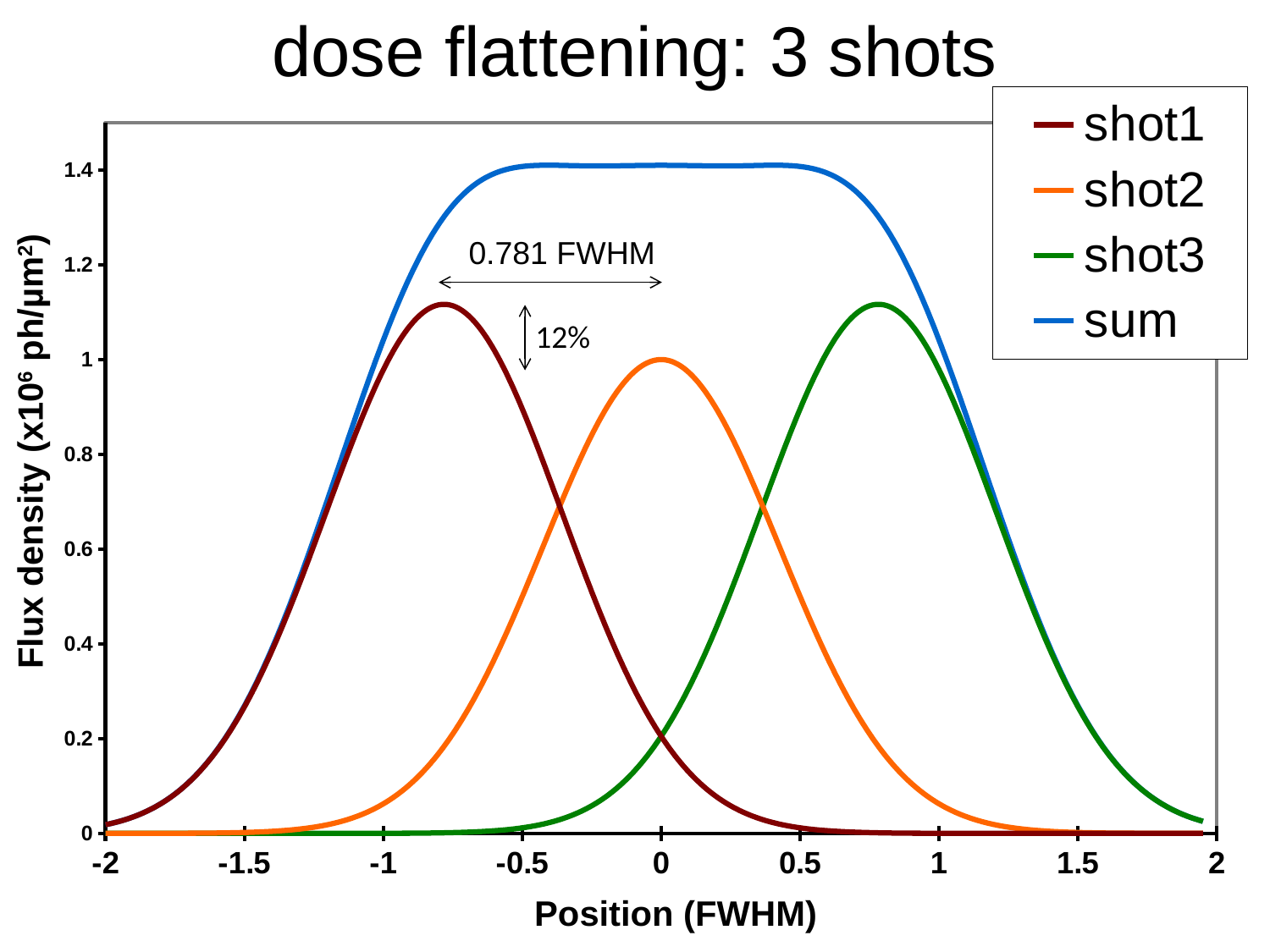
What kind of chart is shown on the slide? line chart What spacing between the shot peaks is annotated on the chart? 0.781 FWHM How many series does the legend list? 4 What is the label of the x axis? Position (FWHM) At position 0, which series has the higher value, shot1 or shot2? shot2 Is the value of shot3 at position 0 greater or less than 0.4? less Is the peak value of shot1 greater or less than 1.2? less At position -1, which series has the higher value, shot1 or shot2? shot1 Is the value of the sum curve at position 0 greater or less than 1.2? greater What is the title of the chart? dose flattening: 3 shots Which series reaches the highest flux density? sum